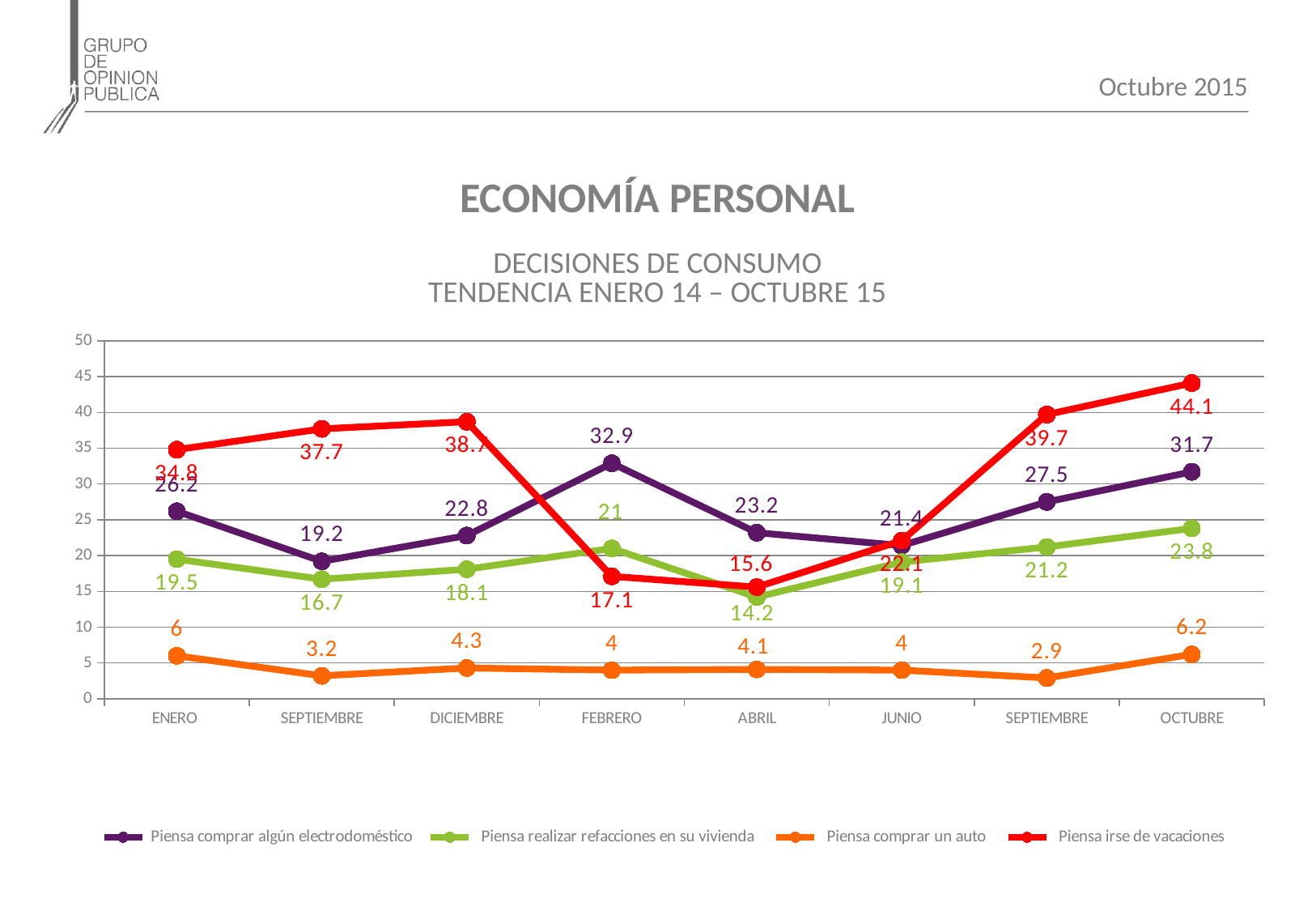
In OCTUBRE, what is the difference between 'Piensa comprar algún electrodoméstico' and 'Piensa realizar refacciones en su vivienda'? 7.9 In FEBRERO, which is larger: 'Piensa comprar algún electrodoméstico' or 'Piensa irse de vacaciones'? Piensa comprar algún electrodoméstico In which month does 'Piensa comprar algún electrodoméstico' reach its highest value? FEBRERO Does 'Piensa irse de vacaciones' rise or fall from JUNIO to OCTUBRE? Rise What is the value for 'Piensa comprar un auto' in the second SEPTIEMBRE (2015)? 2.9 How many time points are plotted along the x axis? 8 In which month does 'Piensa realizar refacciones en su vivienda' reach its lowest value? ABRIL What kind of chart is shown on the slide? Line chart How many series does the legend list? 4 What is the value for 'Piensa comprar un auto' in ABRIL? 4.1 Is the value for 'Piensa irse de vacaciones' in the second SEPTIEMBRE (2015) greater or less than 35? greater What is the value for 'Piensa irse de vacaciones' in OCTUBRE? 44.1